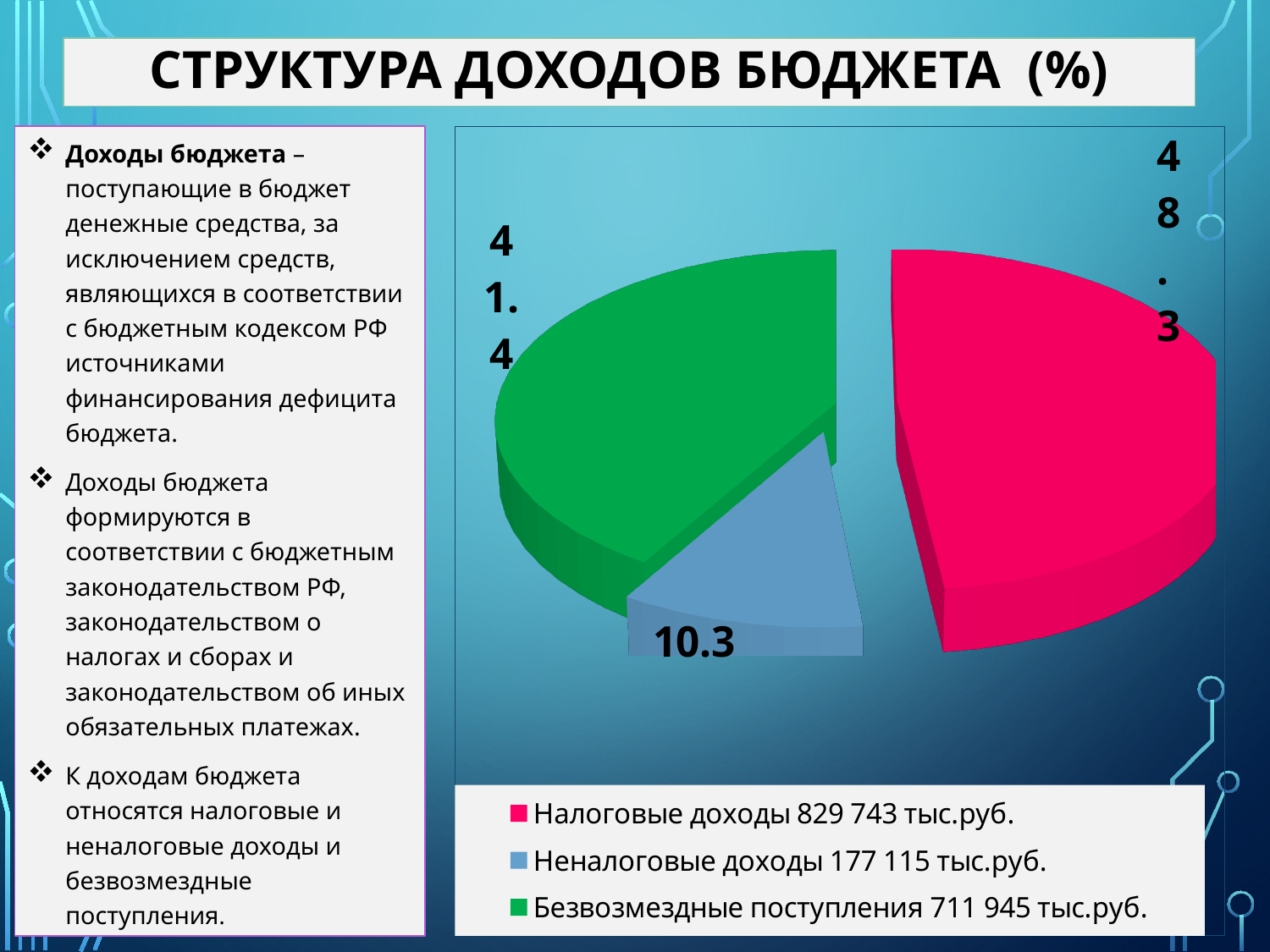
What is the difference in percentage points between Налоговые доходы and Безвозмездные поступления? 6.9 Which is larger: the share of Безвозмездные поступления or the share of Неналоговые доходы? Безвозмездные поступления What is the title of the chart? СТРУКТУРА ДОХОДОВ БЮДЖЕТА (%) What percentage share is shown for Налоговые доходы? 48.3 What percentage share is shown for Безвозмездные поступления? 41.4 Which category has the largest slice of the pie? Налоговые доходы What kind of chart is shown on the slide? pie chart How many slices does the pie chart have? 3 Which category has the smallest slice of the pie? Неналоговые доходы What percentage share is shown for Неналоговые доходы? 10.3 What is the difference in percentage points between Налоговые доходы and Неналоговые доходы? 38 What colour is the slice for Безвозмездные поступления? green